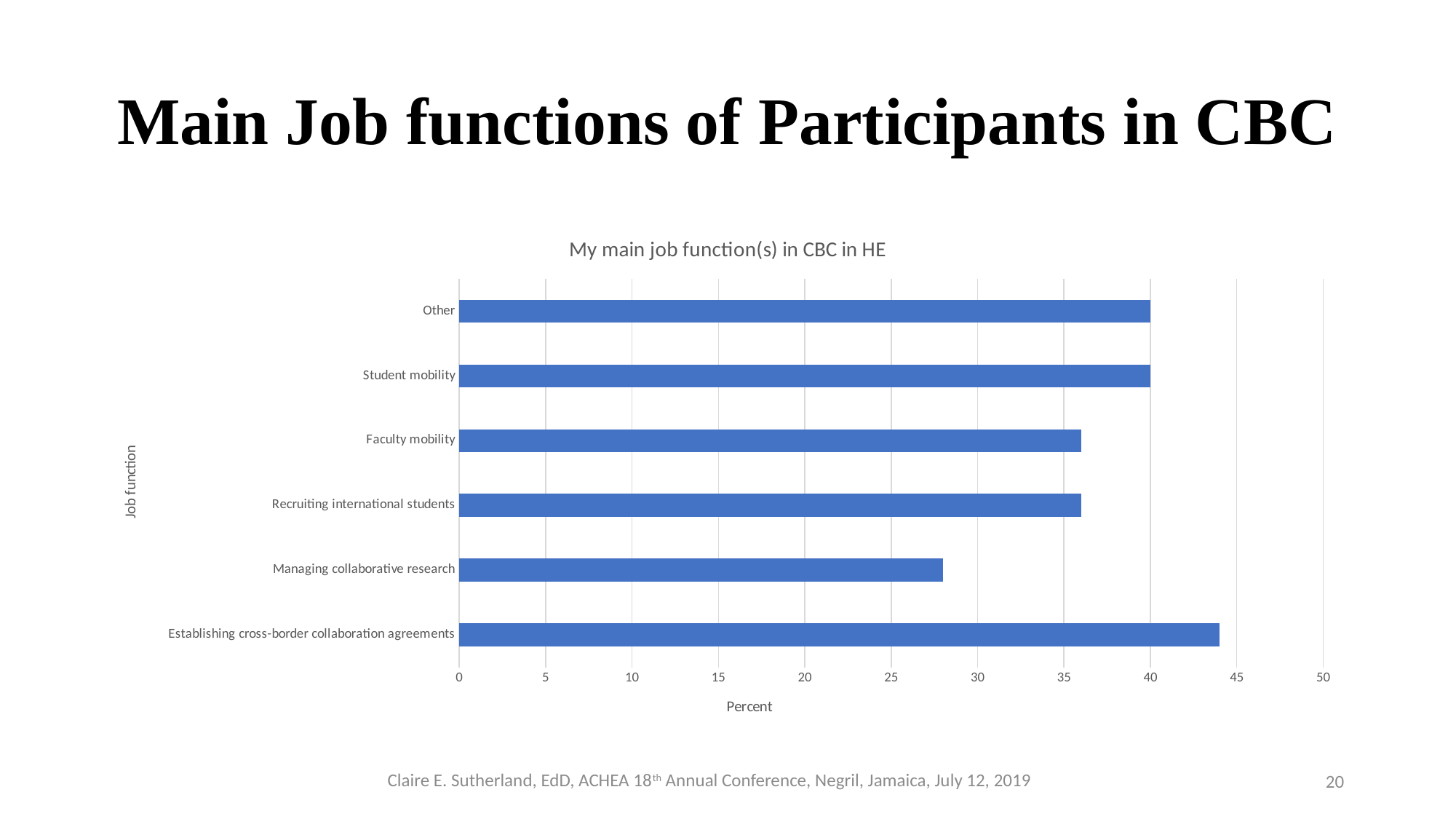
Which job function has the highest percentage? Establishing cross-border collaboration agreements What is the title of the chart? My main job function(s) in CBC in HE Is the value for Establishing cross-border collaboration agreements greater or less than 40? greater What is the label of the horizontal axis? Percent What type of chart is shown on the slide? Bar chart Is the value for Managing collaborative research greater or less than 30? less Which is larger: the value for Recruiting international students or the value for Managing collaborative research? Recruiting international students What is the percentage for Other? 40 Is the value for Faculty mobility greater or less than 35? greater Which job function has the lowest percentage? Managing collaborative research What is the percentage for Student mobility? 40 How many job function categories are plotted in the chart? 6